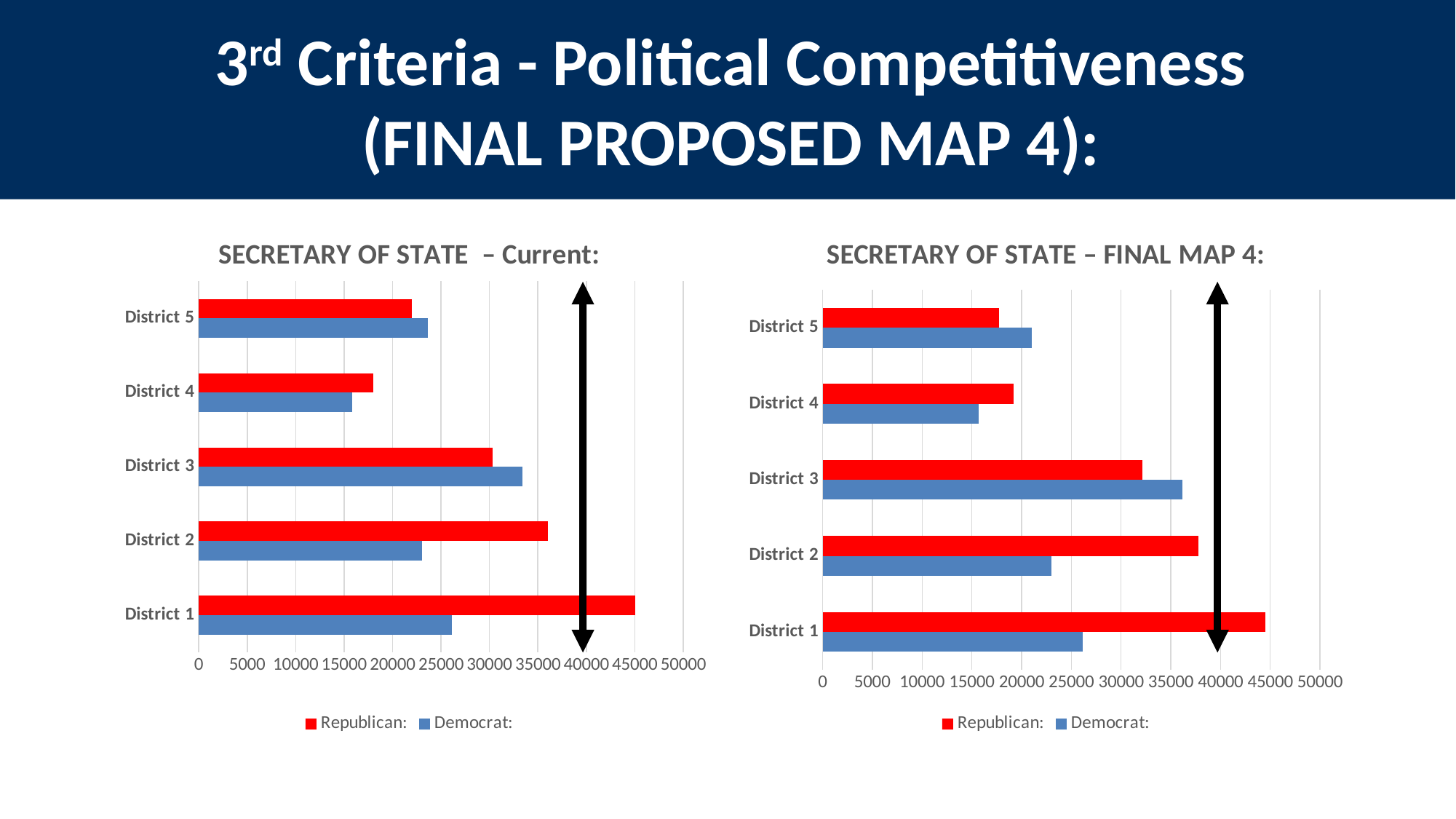
How many districts are shown on the SECRETARY OF STATE – FINAL MAP 4 chart? 5 On the SECRETARY OF STATE – Current chart, what colour represents the Republican series? red On the SECRETARY OF STATE – Current chart, which district has the lowest Republican value? District 4 On the SECRETARY OF STATE – FINAL MAP 4 chart, which is larger for District 2, the Republican value or the Democrat value? Republican How many series does the legend of the SECRETARY OF STATE – Current chart list? 2 On the SECRETARY OF STATE – FINAL MAP 4 chart, which district has the lowest Democrat value? District 4 On the SECRETARY OF STATE – Current chart, is the Republican value for District 1 greater or less than 40000? greater On the SECRETARY OF STATE – Current chart, which district has the highest Republican value? District 1 On the SECRETARY OF STATE – FINAL MAP 4 chart, is the Republican value for District 2 greater or less than 35000? greater On the SECRETARY OF STATE – FINAL MAP 4 chart, which district has the highest Democrat value? District 3 What kind of chart is the SECRETARY OF STATE – Current chart? bar chart On the SECRETARY OF STATE – Current chart, which is larger for District 3, the Republican value or the Democrat value? Democrat